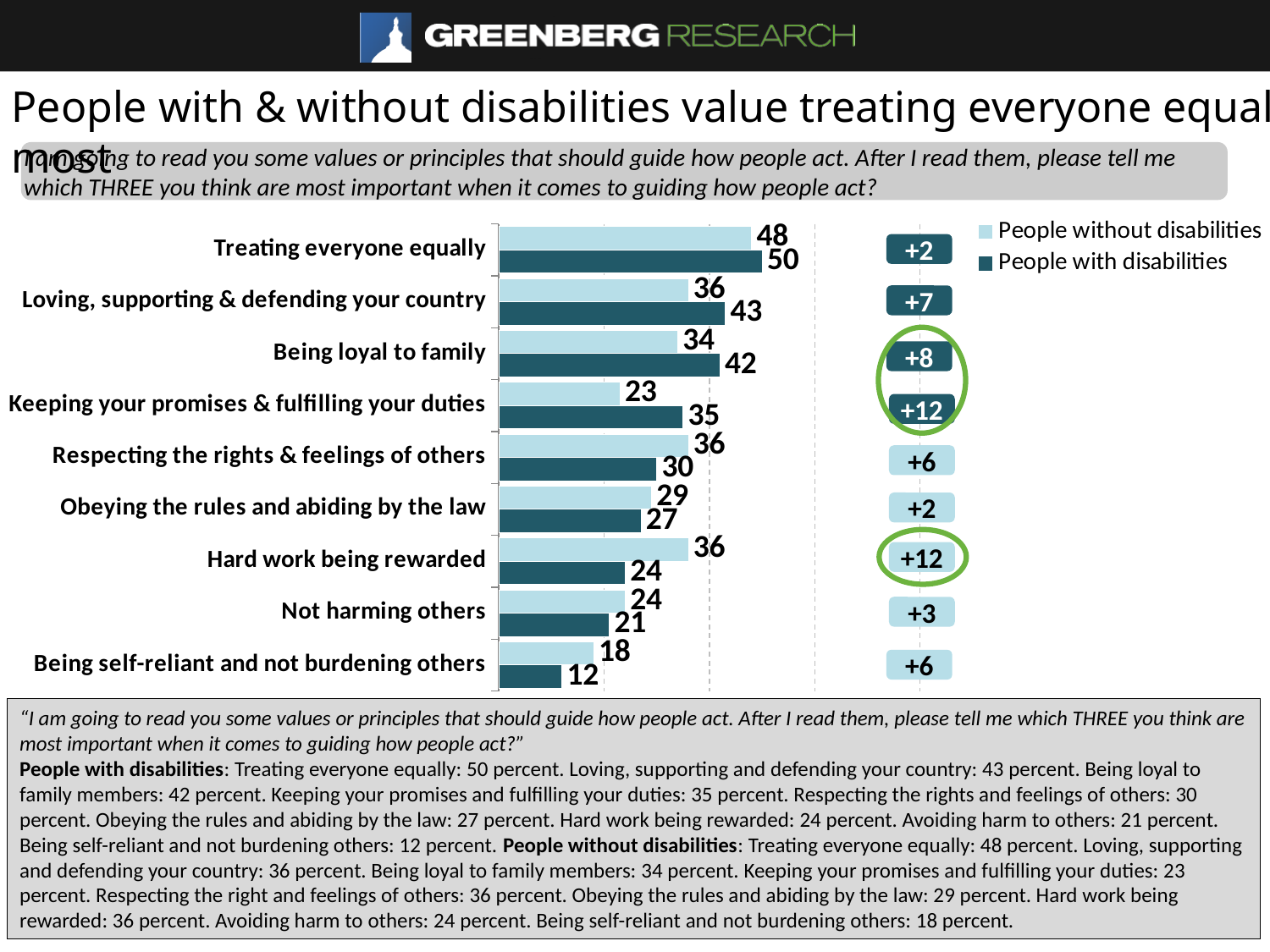
Which series is shown in the darker teal colour in the legend? People with disabilities Which category has the lowest value for People without disabilities? Being self-reliant and not burdening others What is the value for People without disabilities for 'Hard work being rewarded'? 36 What is the value for People with disabilities for 'Being self-reliant and not burdening others'? 12 What is the value for People with disabilities for 'Treating everyone equally'? 50 How many series does the legend list? 2 For 'Respecting the rights & feelings of others', which series has the larger value? People without disabilities For 'Loving, supporting & defending your country', which series has the larger value? People with disabilities How many value categories are plotted on the chart? 9 What is the difference between People with disabilities and People without disabilities for 'Keeping your promises & fulfilling your duties'? 12 What kind of chart is shown on the slide? Bar chart Which category has the highest value for People with disabilities? Treating everyone equally